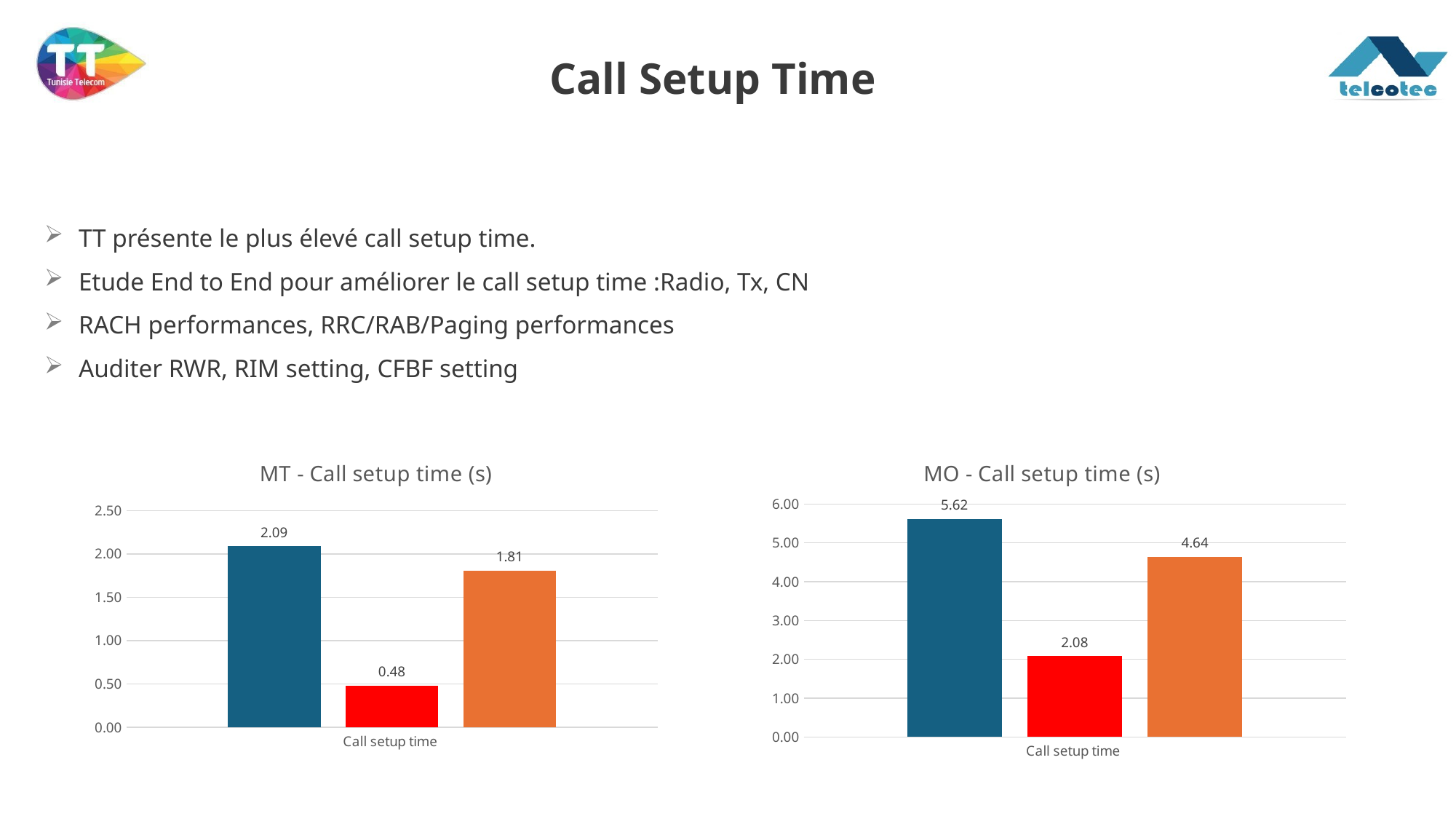
In the 'MT - Call setup time (s)' chart, what is the value of the blue bar? 2.09 In the 'MO - Call setup time (s)' chart, which bar is the highest? the blue bar (5.62) In the 'MT - Call setup time (s)' chart, which bar is the lowest? the red bar (0.48) How many bars are plotted in the 'MT - Call setup time (s)' chart? 3 In the 'MT - Call setup time (s)' chart, which is larger, the blue bar or the orange bar? the blue bar What type of chart is the 'MO - Call setup time (s)' chart? bar chart In the 'MO - Call setup time (s)' chart, what is the value of the blue bar? 5.62 In the 'MO - Call setup time (s)' chart, what is the value of the orange bar? 4.64 In the 'MO - Call setup time (s)' chart, what is the value of the red bar? 2.08 In the 'MO - Call setup time (s)' chart, what is the difference between the blue bar and the orange bar? 0.98 In the 'MT - Call setup time (s)' chart, what is the value of the orange bar? 1.81 In the 'MT - Call setup time (s)' chart, what is the value of the red bar? 0.48